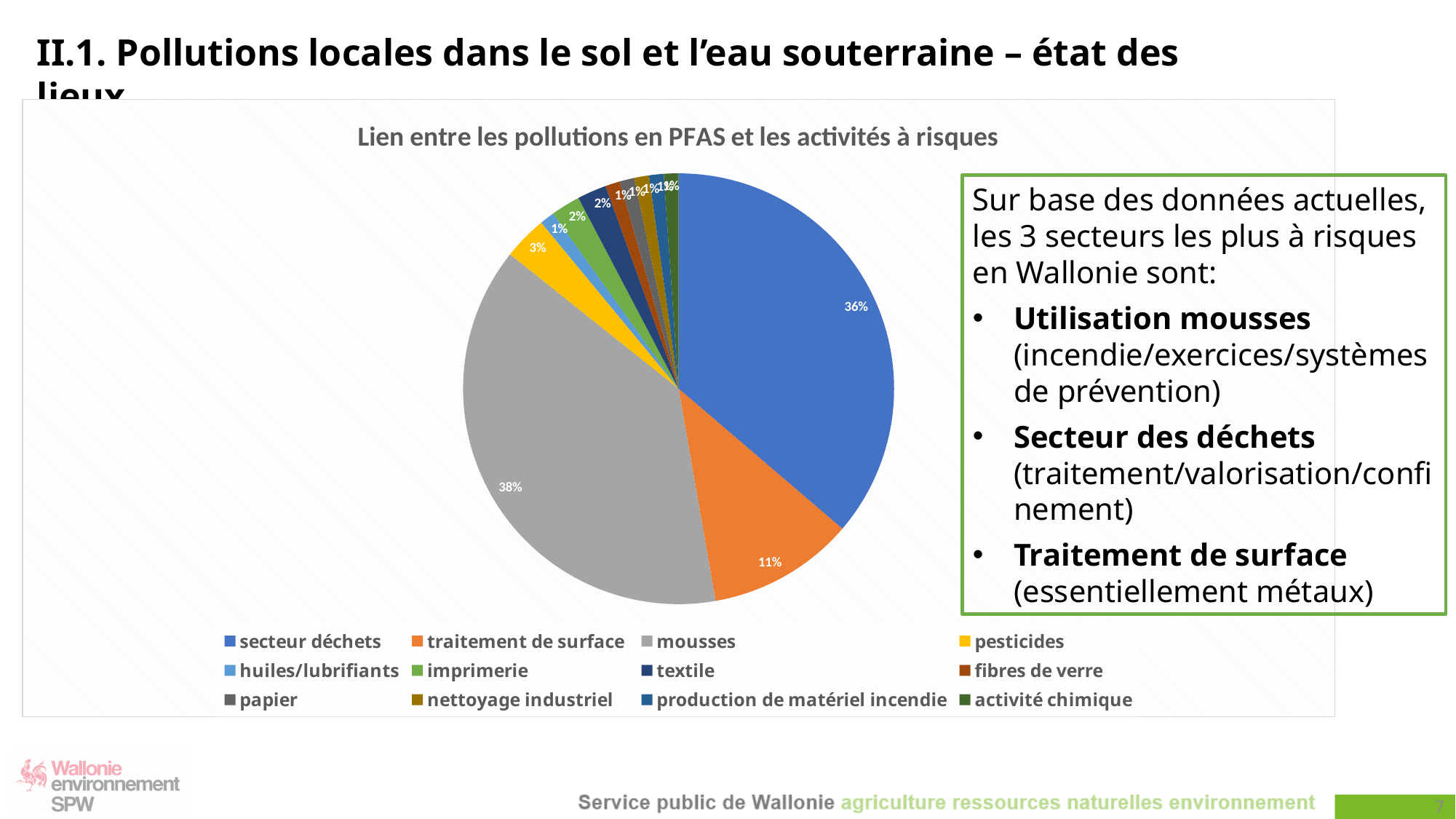
What is the difference in percentage points between the 'mousses' slice and the 'secteur déchets' slice? 2 percentage points What share of the pie does 'imprimerie' represent? 2% What is the title of the chart? Lien entre les pollutions en PFAS et les activités à risques Which category has the largest slice of the pie? mousses What share of the pie does 'traitement de surface' represent? 11% What colour is the 'mousses' slice in the pie chart? grey Which is larger, the slice for 'secteur déchets' or the slice for 'traitement de surface'? secteur déchets What share of the pie does 'secteur déchets' represent? 36% How many categories does the legend of the pie chart list? 12 What kind of chart is shown on the slide? pie chart